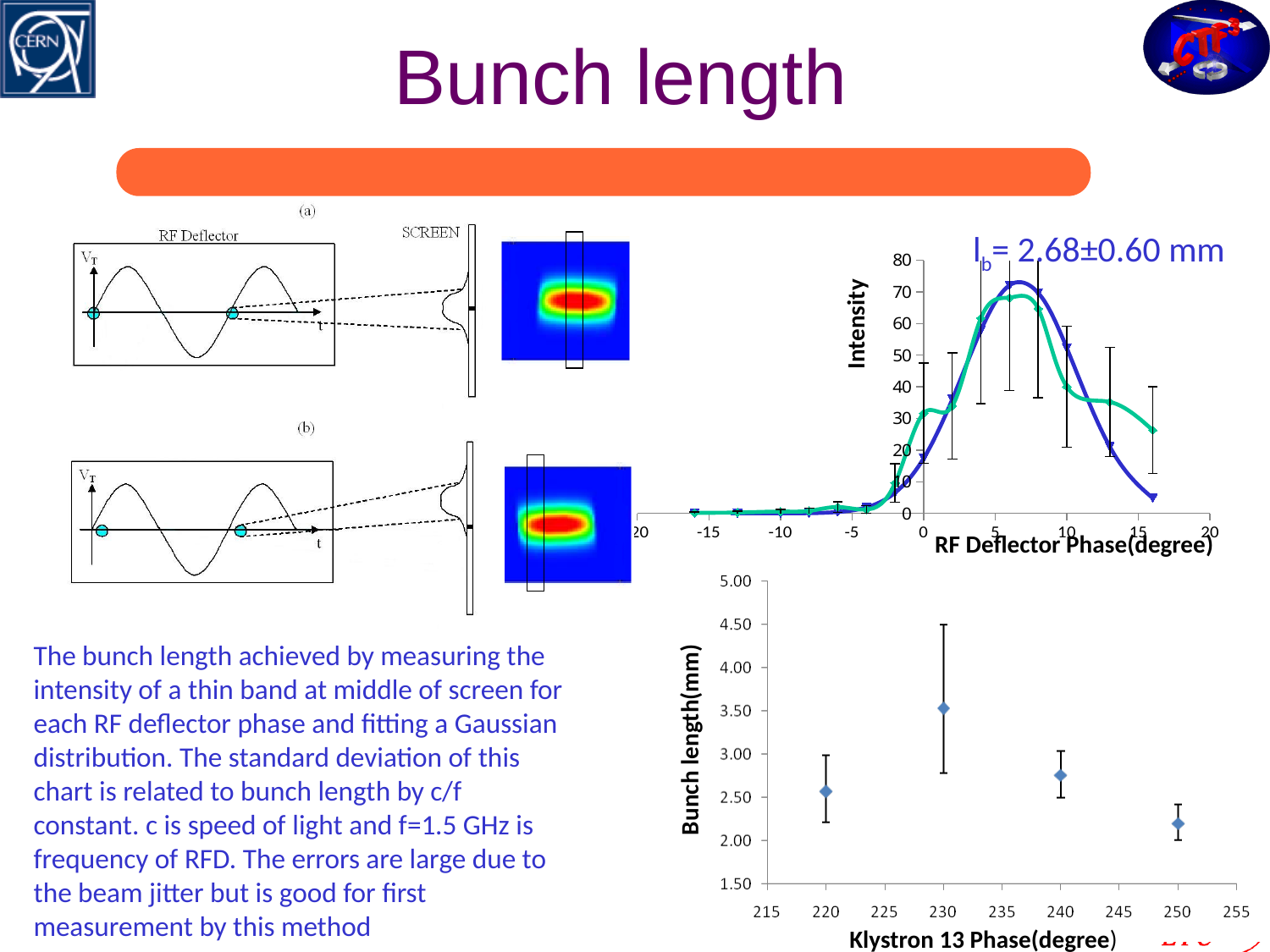
In the bottom-right chart (Bunch length vs Klystron 13 Phase), which has the larger bunch length: phase 230 or phase 240? 230 In the bottom-right chart (Bunch length vs Klystron 13 Phase), is the bunch length at phase 230 greater or less than 3.00 mm? greater In the bottom-right chart (Bunch length vs Klystron 13 Phase), is the bunch length at phase 250 greater or less than 2.50 mm? less In the bottom-right chart (Bunch length vs Klystron 13 Phase), at which Klystron 13 phase is the bunch length highest? 230 In the bottom-right chart (Bunch length vs Klystron 13 Phase), at which Klystron 13 phase is the bunch length lowest? 250 What is the y-axis label of the top-right chart? Intensity In the top-right chart (Intensity vs RF Deflector Phase), does the intensity rise or fall as the RF deflector phase goes from 10 to 15 degrees? fall In the top-right chart (Intensity vs RF Deflector Phase), is the peak intensity greater or less than 60? greater What kind of chart is the bottom-right chart of bunch length versus Klystron 13 phase? scatter chart What is the x-axis label of the bottom-right chart? Klystron 13 Phase(degree) In the bottom-right chart (Bunch length vs Klystron 13 Phase), how many data points are plotted? 4